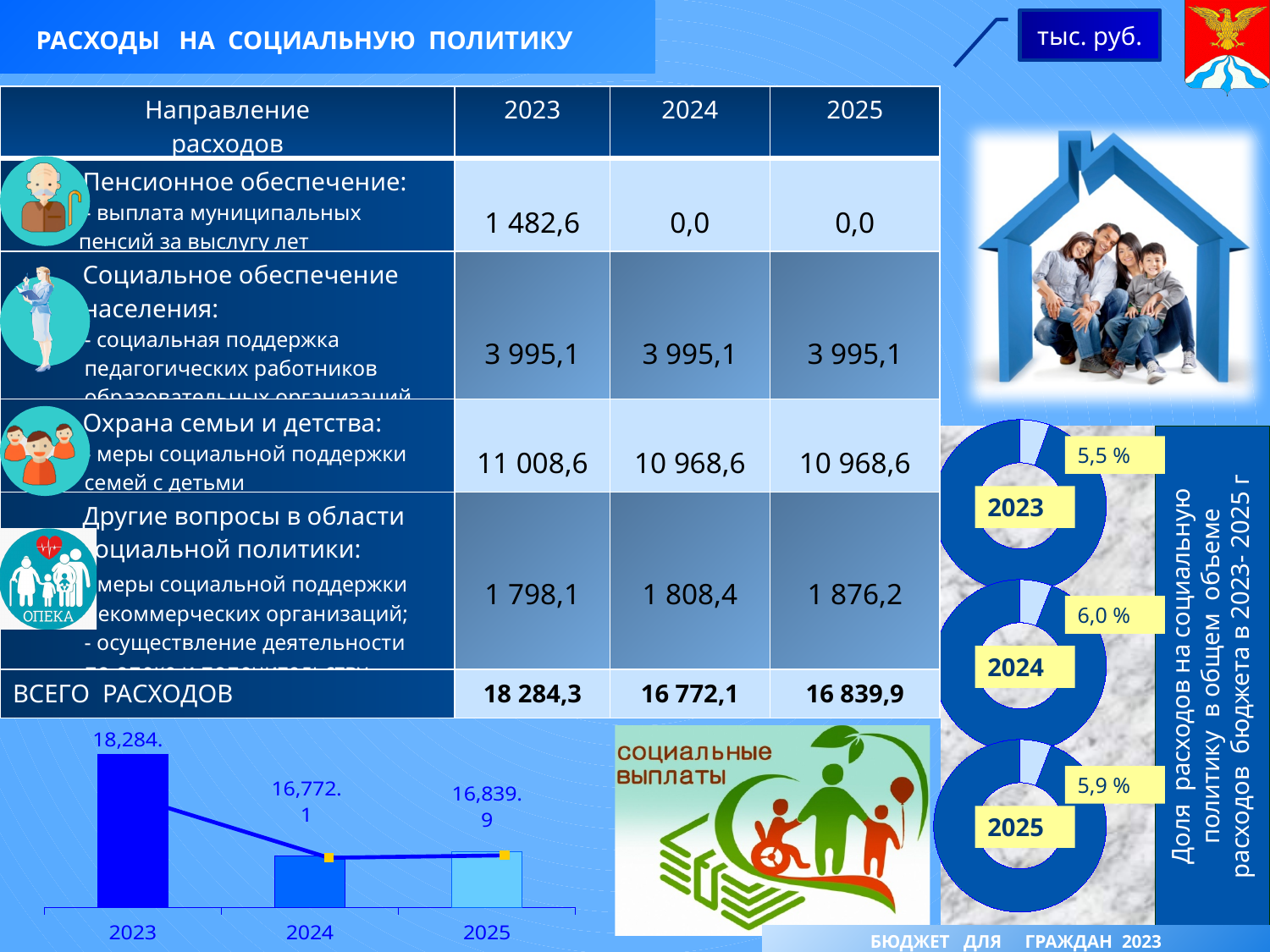
In the bar chart at the bottom left of the slide, which year has the shortest bar? 2024 In the bar chart at the bottom left of the slide, what value is labelled for 2025? 16,839.9 In the bar chart at the bottom left of the slide, does the value fall or rise from 2023 to 2024? fall In the donut charts on the right of the slide, which year has the highest share? 2024 How many bars are shown in the bar chart at the bottom left of the slide? 3 In the bar chart at the bottom left of the slide, is the bar for 2023 taller or shorter than the bar for 2025? taller In the donut charts on the right of the slide, what share is shown for 2024? 6,0 % In the bar chart at the bottom left of the slide, which year has the tallest bar? 2023 In the bar chart at the bottom left of the slide, what is the difference between the 2025 value and the 2024 value? 67.8 In the donut charts on the right of the slide, what share is shown for 2023? 5,5 % What type of chart is shown at the bottom left of the slide? bar chart In the bar chart at the bottom left of the slide, what value is labelled for 2024? 16,772.1